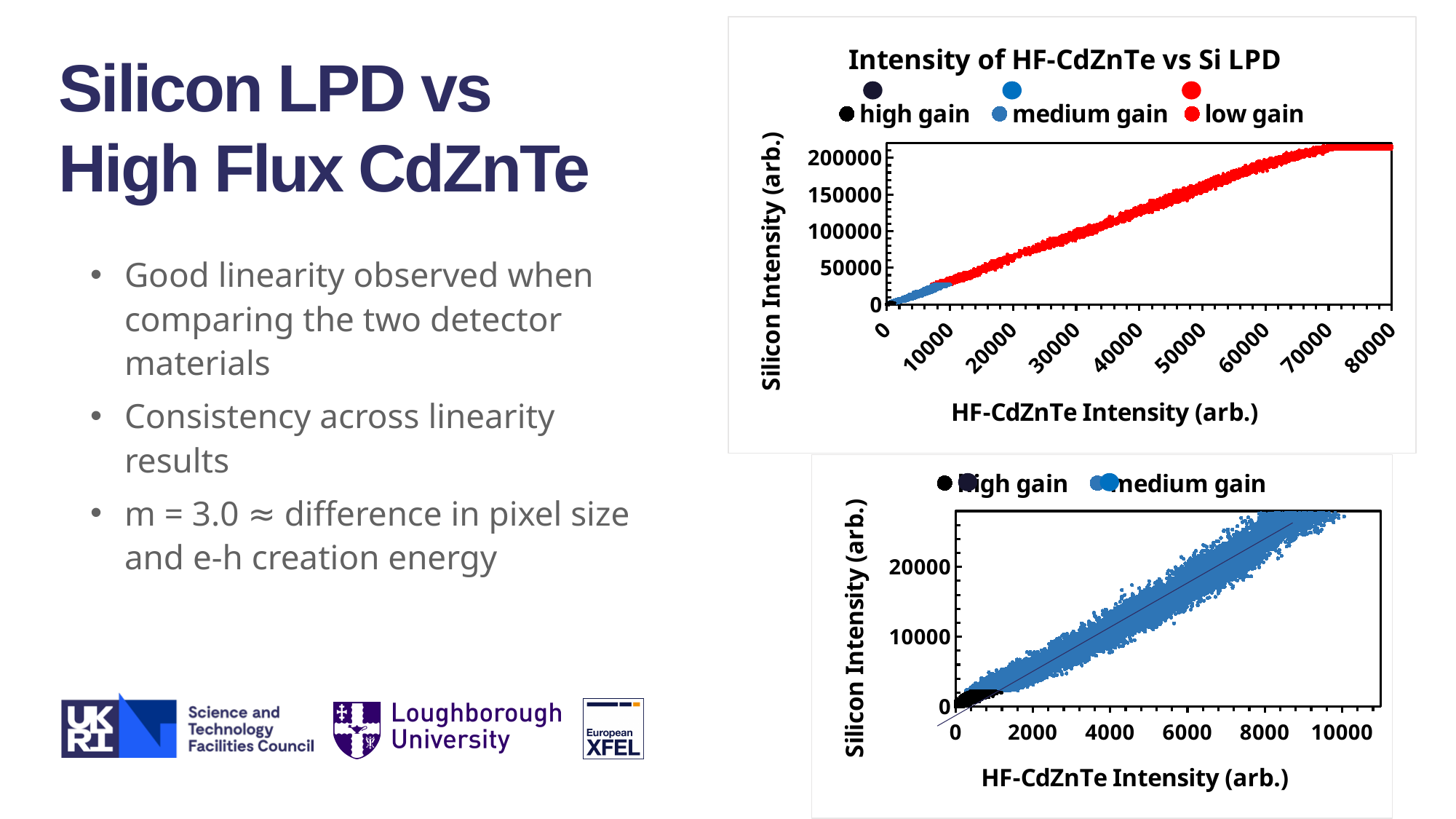
In the bottom chart, does Silicon Intensity rise or fall as HF-CdZnTe Intensity increases? rise What kind of chart is the bottom chart on the slide? scatter chart How many series does the legend of the bottom chart list? 2 What is the title of the top chart? Intensity of HF-CdZnTe vs Si LPD In the top chart 'Intensity of HF-CdZnTe vs Si LPD', is the Silicon Intensity at an HF-CdZnTe Intensity of 10000 greater or less than 50000? less In the top chart 'Intensity of HF-CdZnTe vs Si LPD', does Silicon Intensity rise or fall as HF-CdZnTe Intensity increases? rise In the top chart 'Intensity of HF-CdZnTe vs Si LPD', is the Silicon Intensity at an HF-CdZnTe Intensity of 70000 greater or less than 150000? greater In the top chart 'Intensity of HF-CdZnTe vs Si LPD', which series is plotted in red? low gain What kind of chart is the top chart titled 'Intensity of HF-CdZnTe vs Si LPD'? scatter chart In the bottom chart, is the Silicon Intensity at an HF-CdZnTe Intensity of 2000 greater or less than 10000? less How many series does the legend of the top chart 'Intensity of HF-CdZnTe vs Si LPD' list? 3